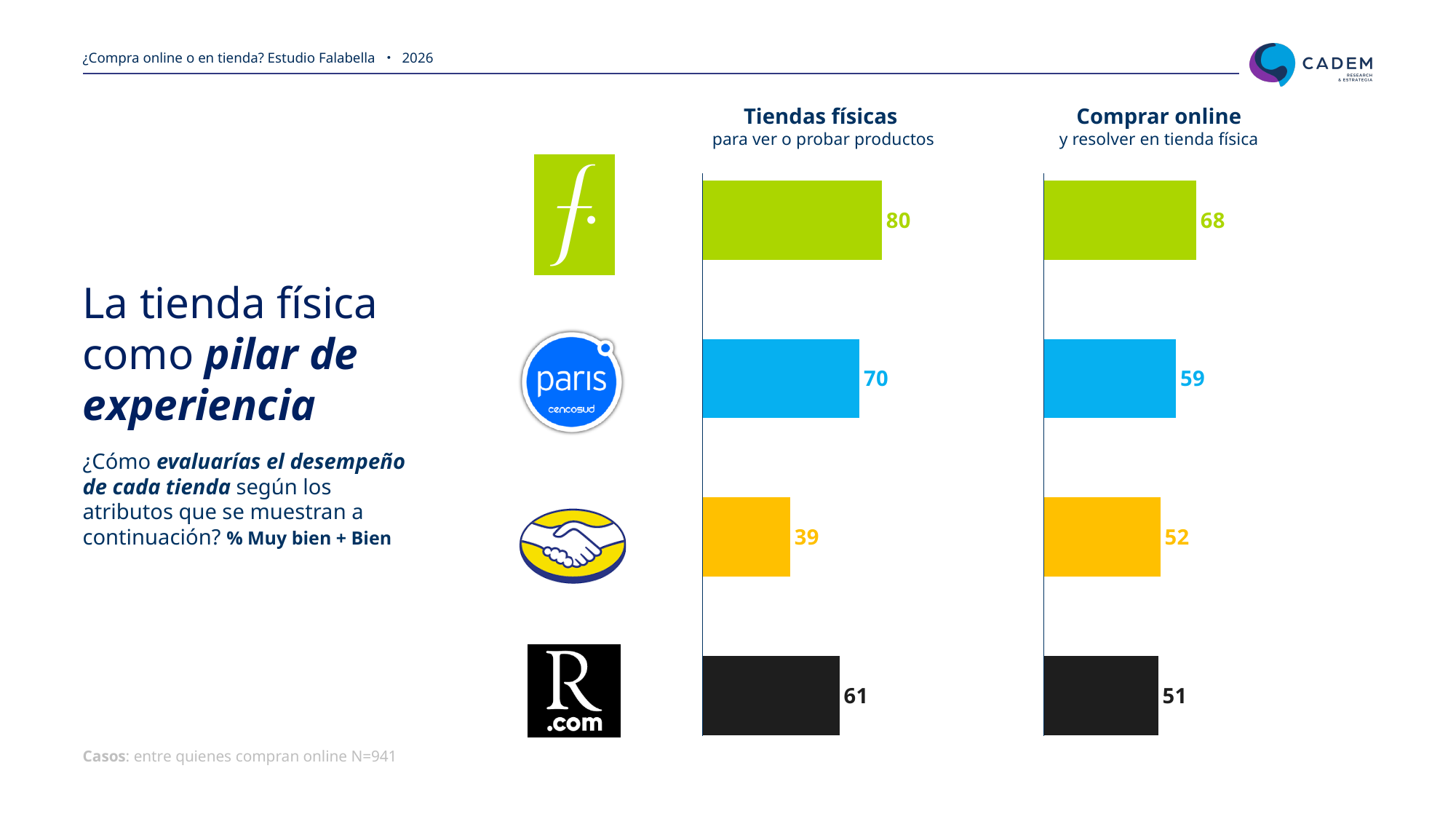
In the 'Tiendas físicas' chart, what is the difference between the values for Paris and R.com? 9 In the 'Tiendas físicas' chart, which brand has the highest value? Falabella (the green 'f' logo) What is the difference between Paris's value in the 'Tiendas físicas' chart and its value in the 'Comprar online' chart? 11 How many brands are shown in the 'Tiendas físicas' chart? 4 What kind of chart is used to show the 'Comprar online' data? Bar chart In the 'Comprar online' chart, what is the value for Paris? 59 In the 'Comprar online' chart, what is the difference between the highest value (Falabella) and the lowest value (R.com)? 17 In the 'Tiendas físicas' chart, what is the value for Paris? 70 In the 'Comprar online' chart, what is the value for the first brand (the green 'f' logo, Falabella)? 68 In the 'Tiendas físicas' chart, which brand has the lowest value? The handshake logo (yellow bar) In the 'Comprar online' chart, which is larger: the value for Paris or the value for the handshake logo (yellow bar)? Paris In the 'Tiendas físicas' chart, what is the value for R.com (Ripley)? 61